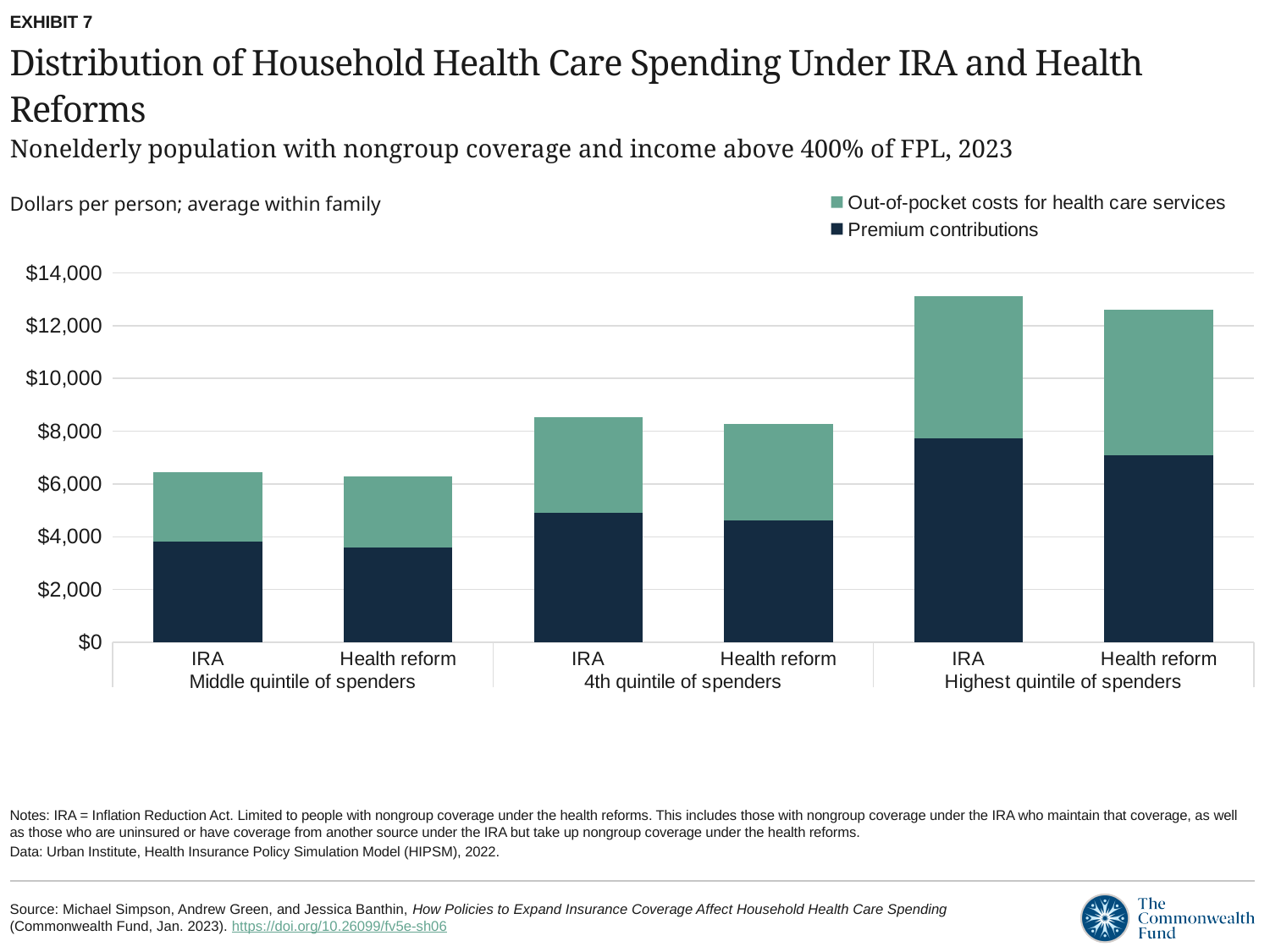
Do total spending bars rise or fall moving from the middle quintile to the highest quintile of spenders? Rise Is the premium contributions value for IRA in the highest quintile of spenders greater or less than $8,000? less Is the total spending for IRA in the 4th quintile of spenders greater or less than $8,000? greater Is the total spending for IRA in the highest quintile of spenders greater or less than $12,000? greater Which quintile group has the lowest total spending bars? Middle quintile of spenders Which bar has the highest total spending? IRA, Highest quintile of spenders What kind of chart is shown on the slide? Stacked bar chart Which colour represents premium contributions in the legend? Dark navy How many series does the legend list? 2 In the highest quintile of spenders, which has the larger total spending: IRA or Health reform? IRA How many bars are plotted in the chart? 6